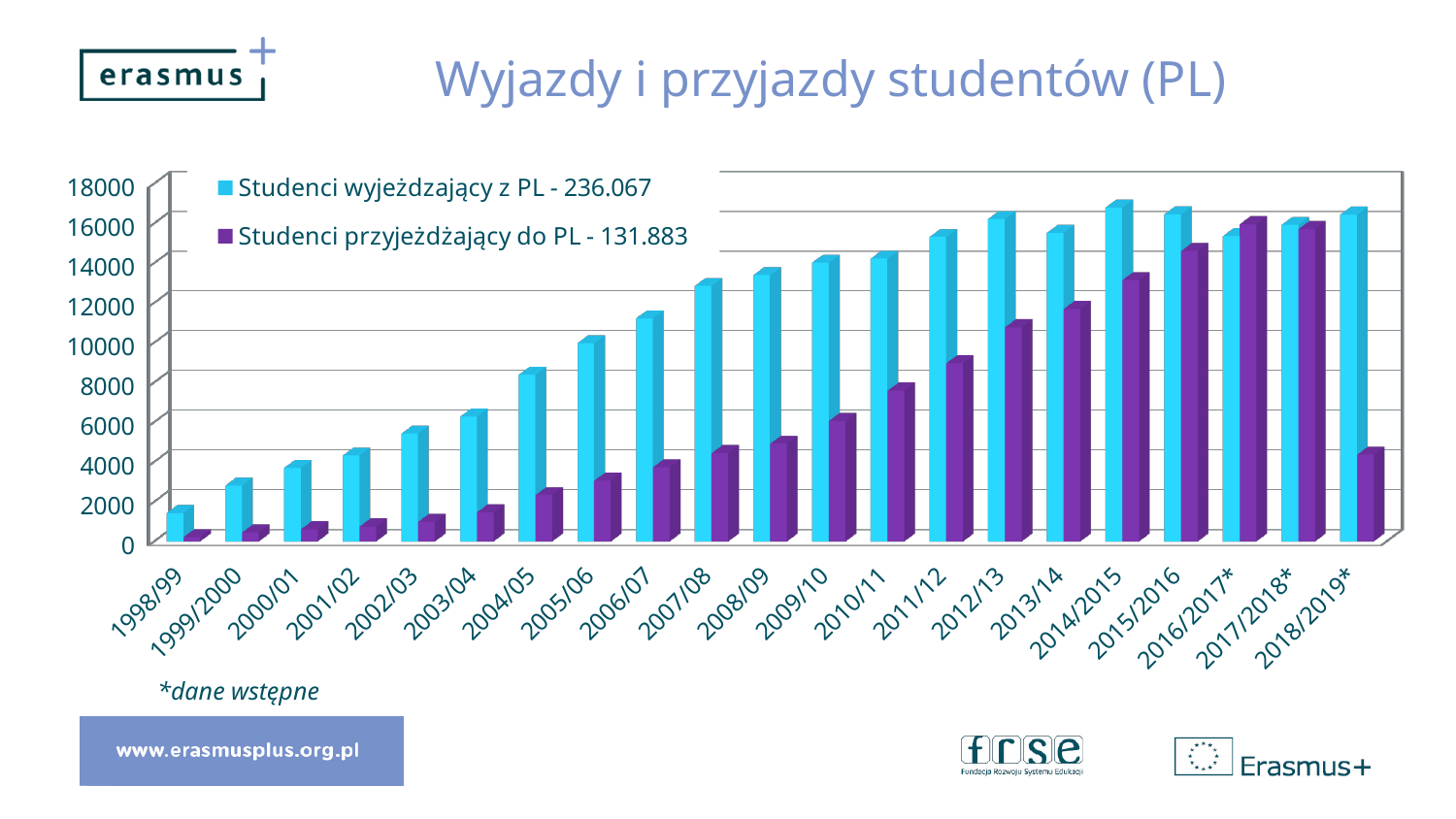
Do the values for 'Studenci przyjeżdżający do PL' generally rise or fall from 1998/99 to 2016/2017*? rise What type of chart is shown on the slide? bar chart In 2010/11, which series has the larger value: 'Studenci wyjeżdżający z PL' or 'Studenci przyjeżdżający do PL'? Studenci wyjeżdżający z PL Which academic year has the lowest value for 'Studenci przyjeżdżający do PL'? 1998/99 How many series does the legend list? 2 Is the value for 'Studenci wyjeżdżający z PL' in 1998/99 greater or less than 2000? less Is the value for 'Studenci przyjeżdżający do PL' in 2018/2019* greater or less than 6000? less Which academic year has the lowest value for 'Studenci wyjeżdżający z PL'? 1998/99 Is the value for 'Studenci wyjeżdżający z PL' in 2014/2015 greater or less than 14000? greater How many academic years are shown on the x axis? 21 What total is given in the legend for 'Studenci wyjeżdżający z PL'? 236.067 What total is given in the legend for 'Studenci przyjeżdżający do PL'? 131.883